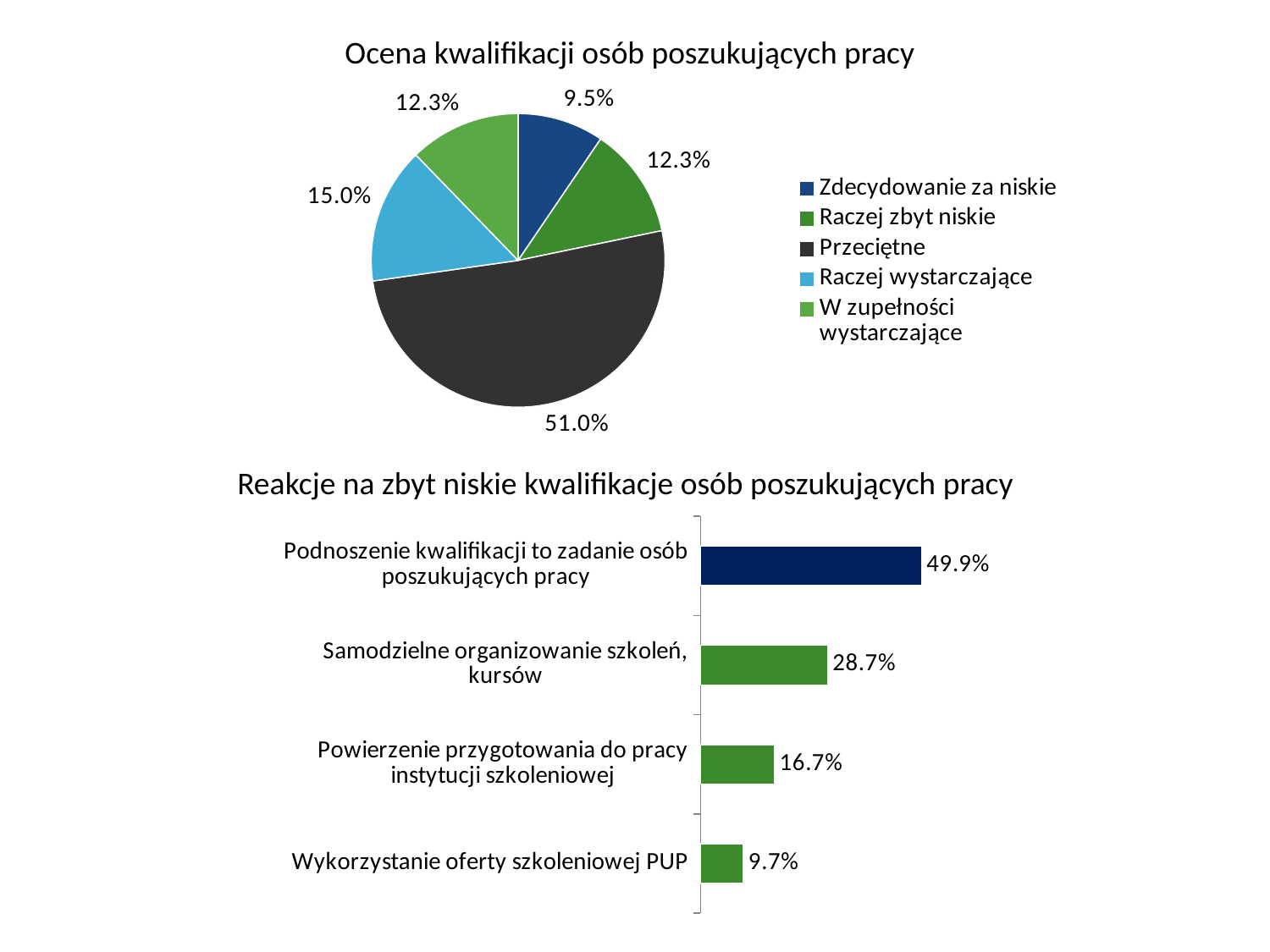
In the bar chart 'Reakcje na zbyt niskie kwalifikacje osób poszukujących pracy', how many categories are shown? 4 In the bar chart 'Reakcje na zbyt niskie kwalifikacje osób poszukujących pracy', what is the value for 'Samodzielne organizowanie szkoleń, kursów'? 28.7% In the pie chart 'Ocena kwalifikacji osób poszukujących pracy', how many categories does the legend list? 5 In the bar chart 'Reakcje na zbyt niskie kwalifikacje osób poszukujących pracy', what is the difference between 'Podnoszenie kwalifikacji to zadanie osób poszukujących pracy' and 'Powierzenie przygotowania do pracy instytucji szkoleniowej'? 33.2% In the bar chart 'Reakcje na zbyt niskie kwalifikacje osób poszukujących pracy', what is the value for 'Wykorzystanie oferty szkoleniowej PUP'? 9.7% In the pie chart 'Ocena kwalifikacji osób poszukujących pracy', which category has the smallest slice? Zdecydowanie za niskie In the pie chart 'Ocena kwalifikacji osób poszukujących pracy', what is the difference between 'Raczej wystarczające' and 'Zdecydowanie za niskie'? 5.5% In the pie chart 'Ocena kwalifikacji osób poszukujących pracy', what share is labelled for 'Przeciętne'? 51.0% In the bar chart 'Reakcje na zbyt niskie kwalifikacje osób poszukujących pracy', which category has the highest value? Podnoszenie kwalifikacji to zadanie osób poszukujących pracy In the pie chart 'Ocena kwalifikacji osób poszukujących pracy', what is the value for 'Raczej wystarczające'? 15.0% In the pie chart 'Ocena kwalifikacji osób poszukujących pracy', what is the value for 'Zdecydowanie za niskie'? 9.5% What type of chart is the top chart on the slide? Pie chart